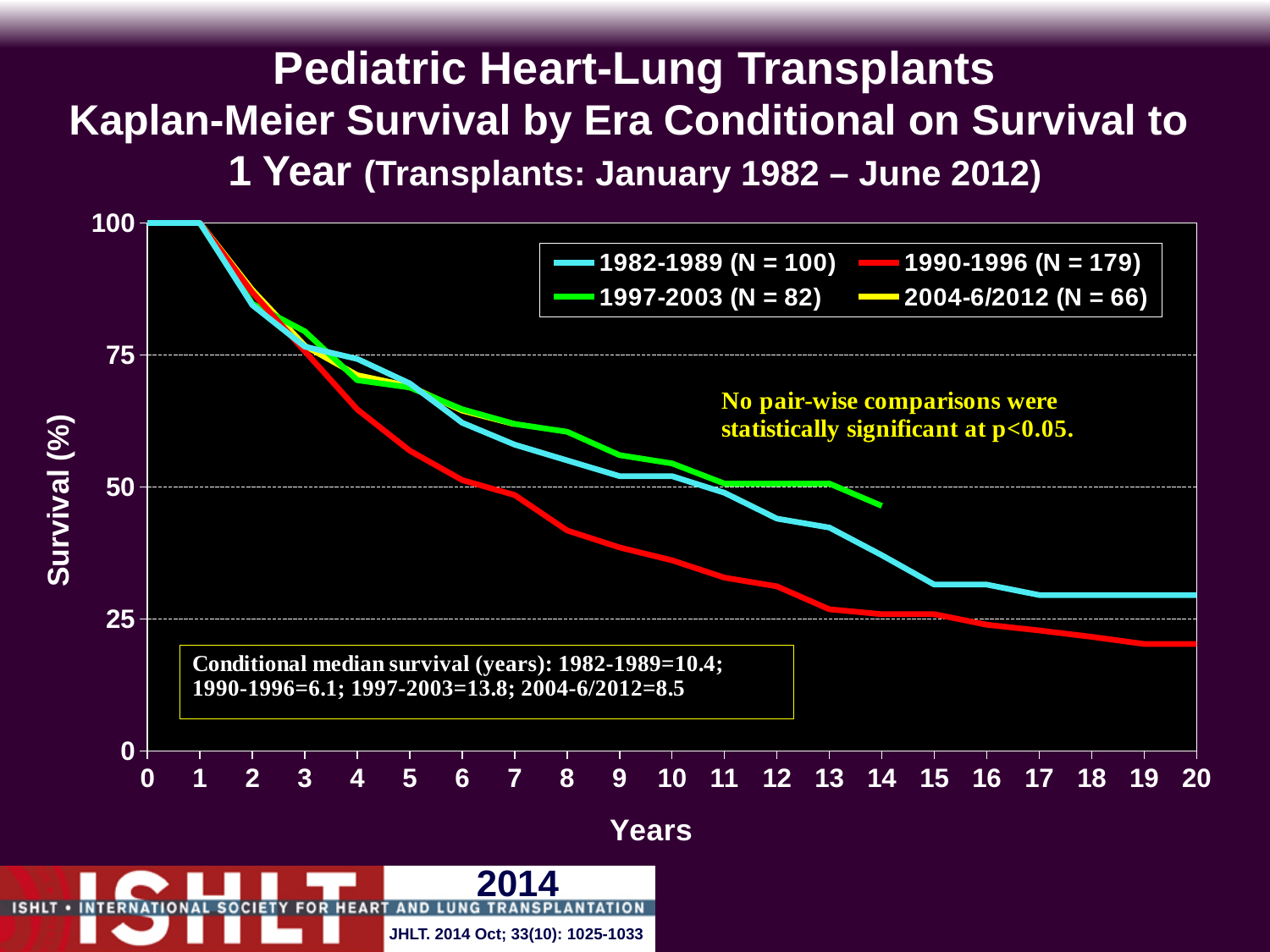
What kind of chart is shown on the slide? Line chart Do the survival curves rise or fall as years increase? fall According to the legend, what is N for the 1990-1996 era? 179 At year 10, which era has higher survival, 1982-1989 or 1990-1996? 1982-1989 Is the survival value for the 1982-1989 era at year 20 greater or less than 25? greater How many series does the legend list? 4 Which era has the lowest conditional median survival? 1990-1996 What is the conditional median survival in years for the 1997-2003 era? 13.8 Is the survival value for the 1990-1996 era at year 20 greater or less than 25? less What is the difference in conditional median survival (years) between the 1997-2003 era and the 1990-1996 era? 7.7 Is the survival value for the 1990-1996 era at year 8 greater or less than 50? less What is the survival value for all eras at year 0? 100